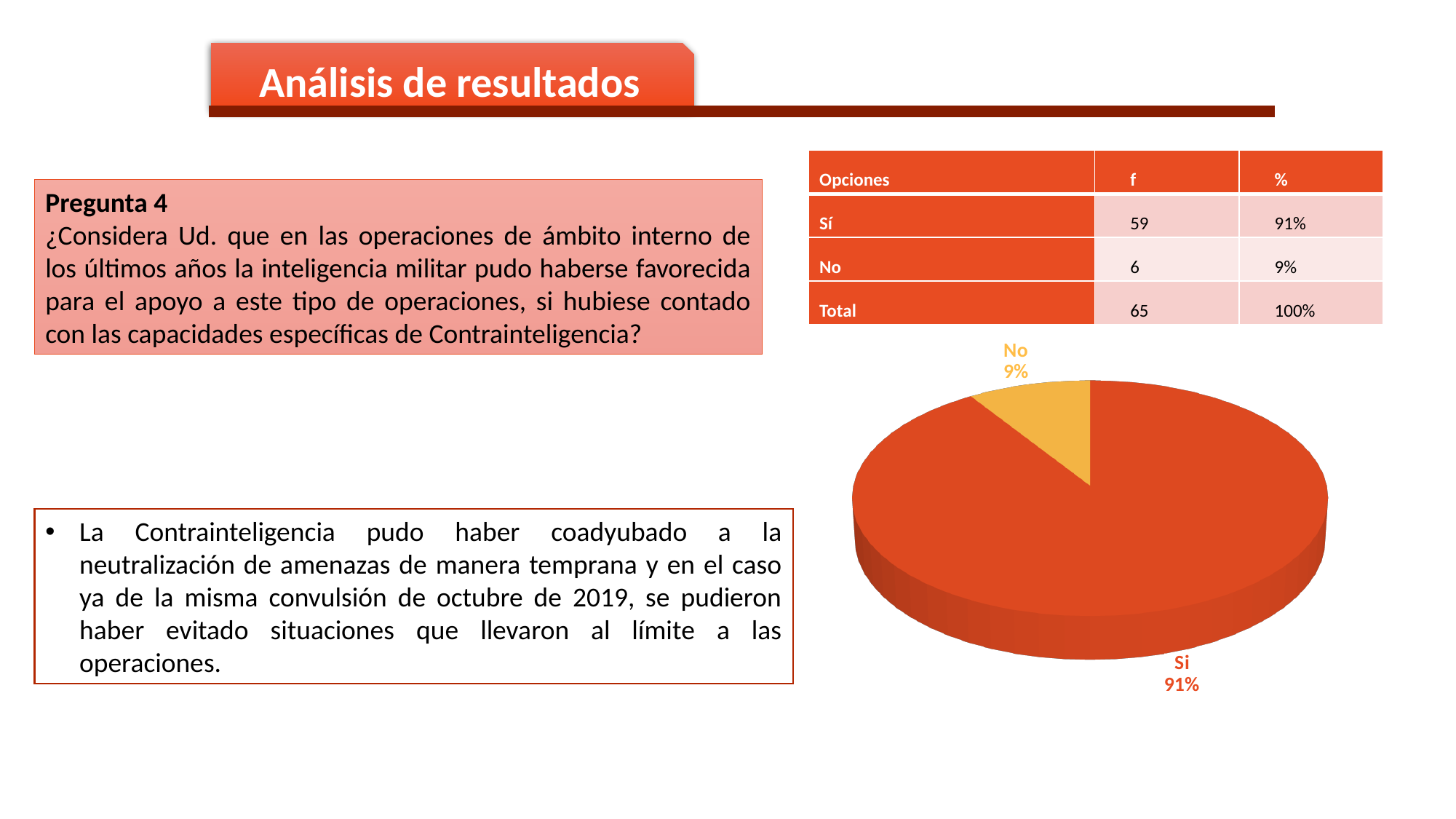
What percentage does the 'Si' slice of the pie chart show? 91% How many slices does the pie chart have? 2 What colour is the 'No' slice of the pie chart? yellow/orange Which slice of the pie chart is the smallest? No What percentage does the 'No' slice of the pie chart show? 9% Which slice of the pie chart is the largest? Si What kind of chart is shown on the slide? pie chart What is the difference in percentage points between the 'Si' slice and the 'No' slice? 82 What colour is the 'Si' slice of the pie chart? red-orange Which is larger in the pie chart, the 'Si' slice or the 'No' slice? Si What share of the pie does the 'No' slice represent? 9%